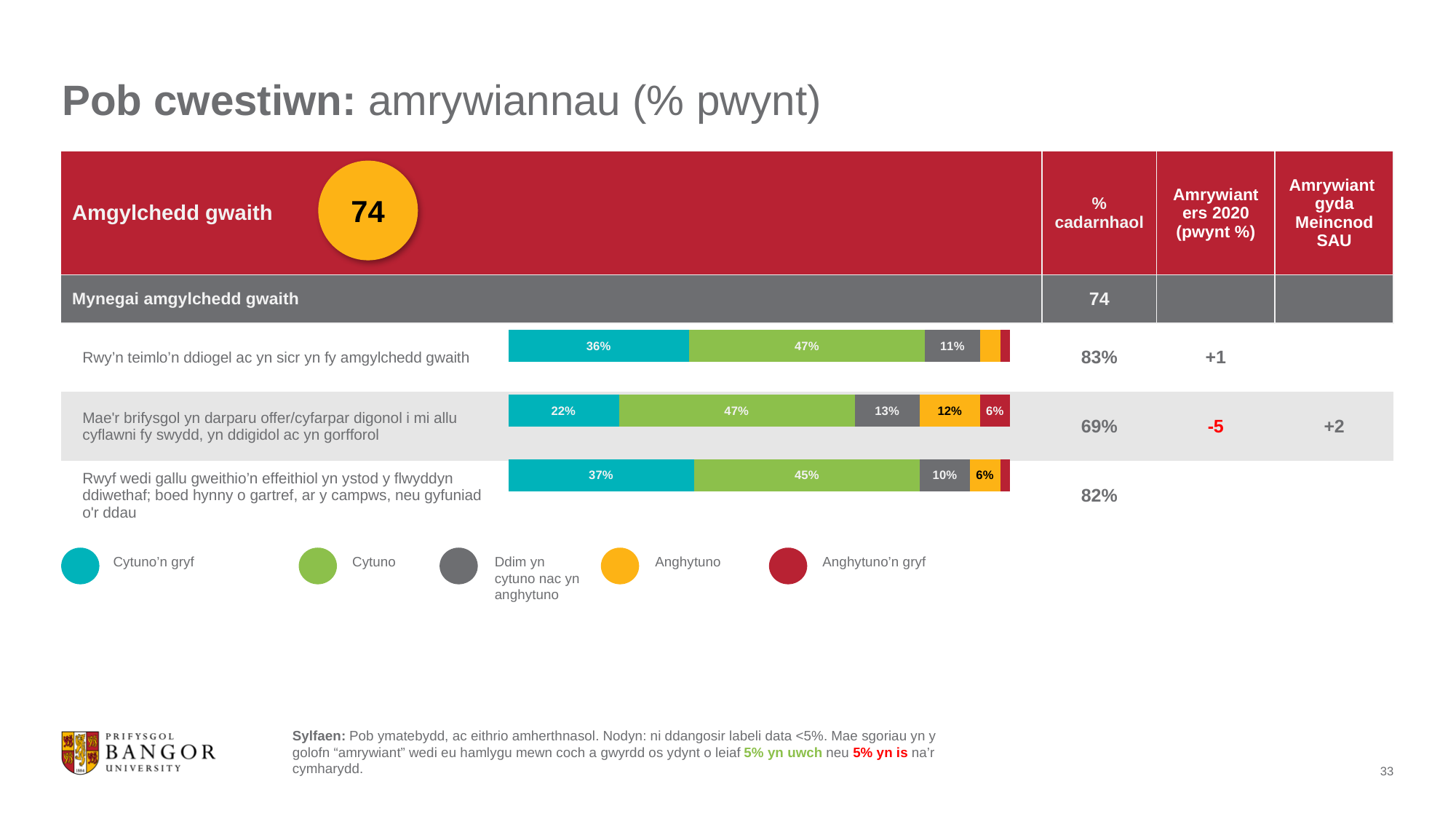
Which is larger: the 'Anghytuno' value for 'Mae'r brifysgol yn darparu offer/cyfarpar digonol...' or for 'Rwyf wedi gallu gweithio'n effeithiol yn ystod y flwyddyn ddiwethaf...'? Mae'r brifysgol yn darparu offer/cyfarpar digonol... What is the 'Anghytuno'n gryf' value for the statement 'Mae'r brifysgol yn darparu offer/cyfarpar digonol i mi allu cyflawni fy swydd, yn ddigidol ac yn gorfforol'? 6% How many statements (bars) are plotted in the chart? 3 What is the 'Ddim yn cytuno nac yn anghytuno' value for the statement 'Rwyf wedi gallu gweithio'n effeithiol yn ystod y flwyddyn ddiwethaf'? 10% Which statement has the lowest 'Cytuno'n gryf' value? Mae'r brifysgol yn darparu offer/cyfarpar digonol i mi allu cyflawni fy swydd, yn ddigidol ac yn gorfforol How many series does the legend list? 5 What is the difference between the 'Cytuno'n gryf' values for 'Rwy'n teimlo'n ddiogel ac yn sicr yn fy amgylchedd gwaith' and 'Mae'r brifysgol yn darparu offer/cyfarpar digonol...'? 14 percentage points Which statement has the highest 'Cytuno'n gryf' value? Rwyf wedi gallu gweithio'n effeithiol yn ystod y flwyddyn ddiwethaf; boed hynny o gartref, ar y campws, neu gyfuniad o'r ddau Which colour represents 'Anghytuno' in the legend? orange/yellow What is the 'Cytuno' value for the statement 'Mae'r brifysgol yn darparu offer/cyfarpar digonol i mi allu cyflawni fy swydd, yn ddigidol ac yn gorfforol'? 47% What kind of chart is used to show the responses to each statement? stacked bar chart What is the 'Cytuno'n gryf' value for the statement 'Rwy'n teimlo'n ddiogel ac yn sicr yn fy amgylchedd gwaith'? 36%